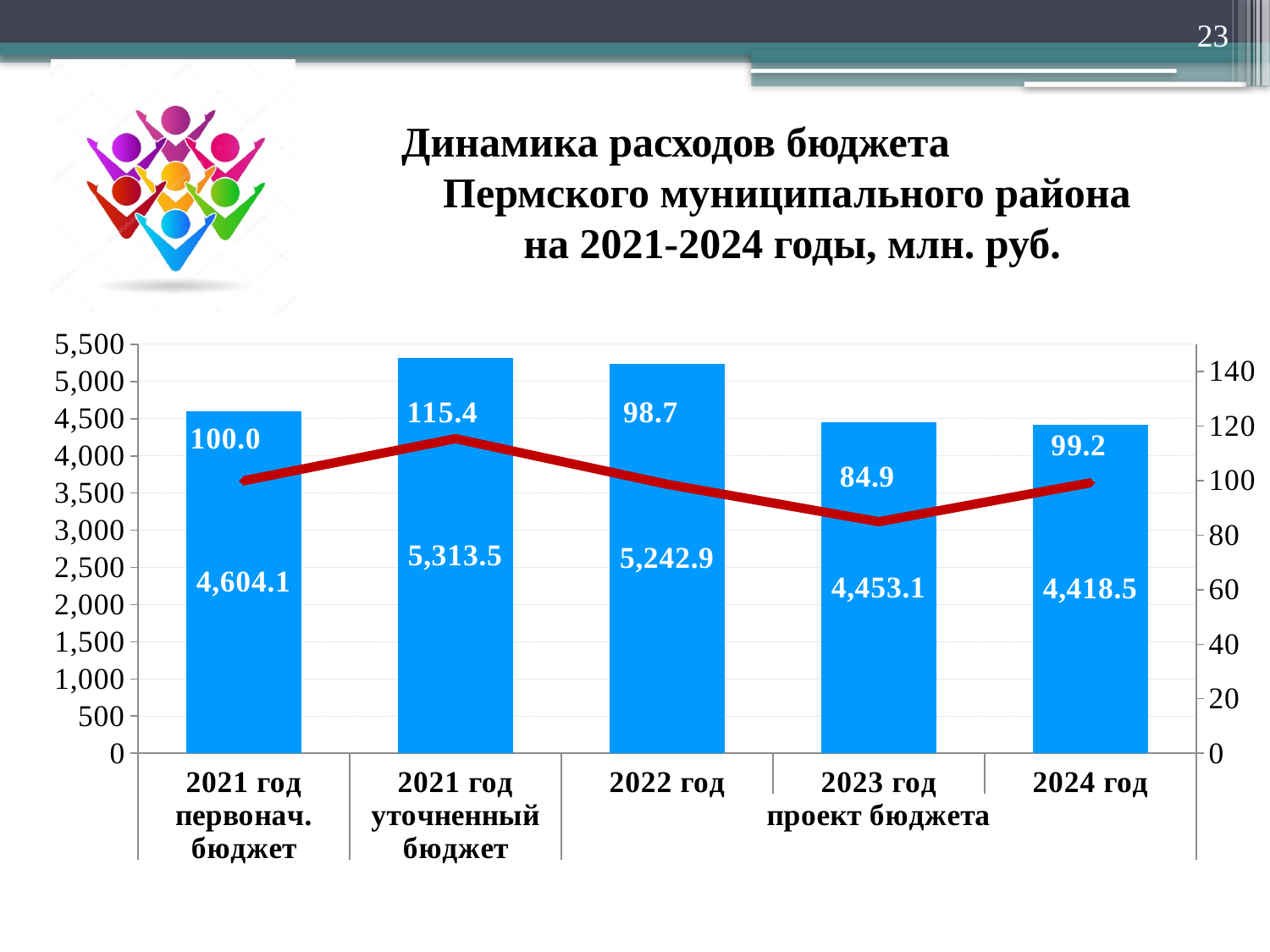
Which category has the highest bar value? 2021 год уточненный бюджет What is the difference between the bar values for 2021 год уточненный бюджет and 2021 год первонач. бюджет? 709.4 Which category has the lowest bar value? 2024 год What is the line value shown for 2024 год? 99.2 Which is larger, the bar value for 2022 год or for 2023 год? 2022 год What is the line value shown for 2023 год? 84.9 Which category has the lowest line value? 2023 год What is the bar value for 2022 год? 5,242.9 How many categories are shown on the x axis? 5 What is the bar value for 2021 год уточненный бюджет? 5,313.5 What is the title of the chart? Динамика расходов бюджета Пермского муниципального района на 2021-2024 годы, млн. руб. Do the bar values rise or fall from 2022 год to 2024 год? fall